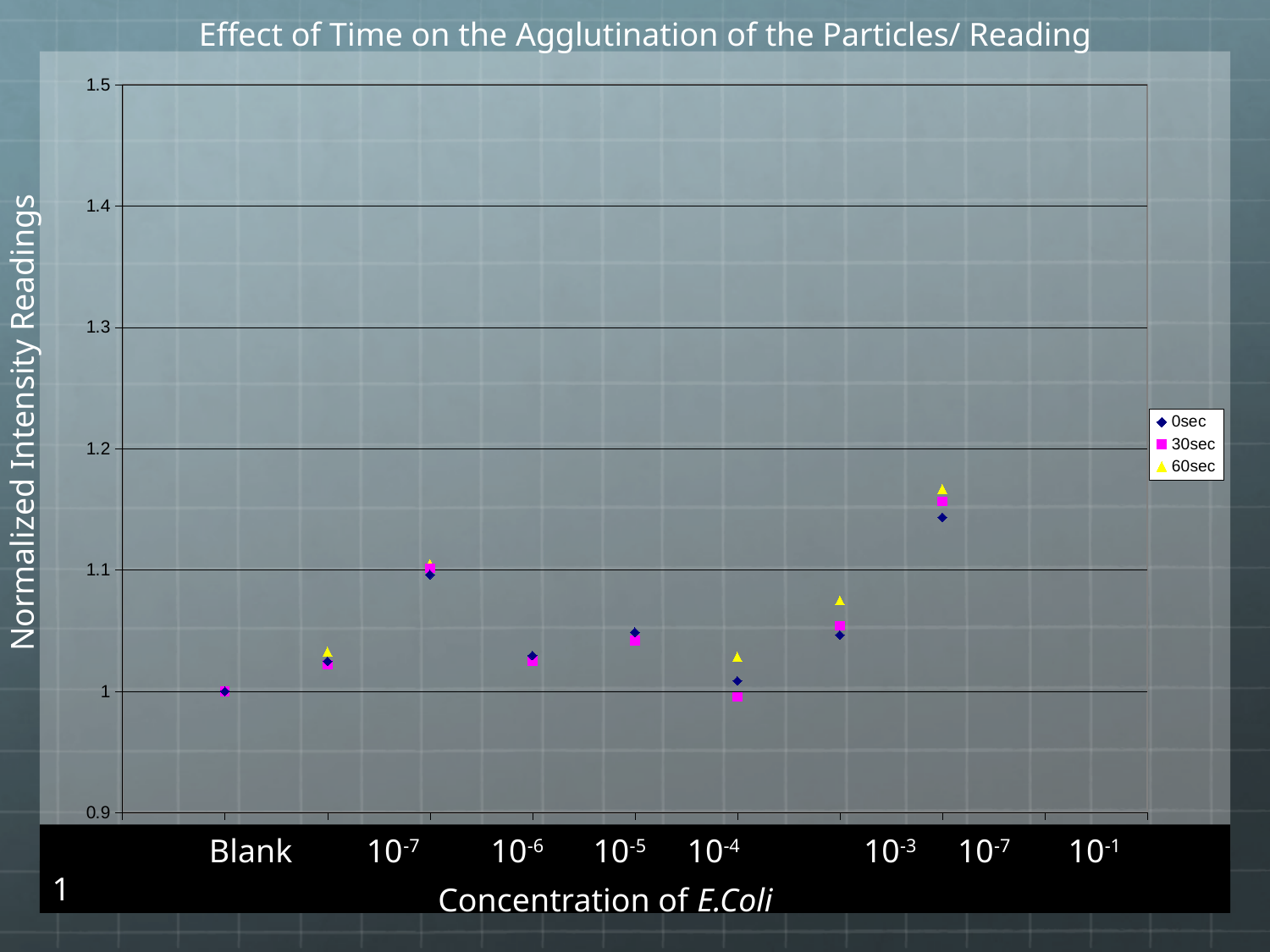
Is the 60sec reading at the rightmost plotted point greater or less than the 0sec reading at that point? greater How many data points are plotted for each series? 8 At the rightmost group of plotted points, which series has the lowest reading? 0sec What are the three series named in the legend? 0sec, 30sec, 60sec What is the maximum value shown on the y axis? 1.5 Is the highest plotted value on the chart greater or less than 1.2? less At the rightmost group of plotted points, which series has the highest reading? 60sec Is the highest plotted value on the chart greater or less than 1.1? greater What kind of chart is shown on the slide? scatter chart What is the normalized intensity reading for the Blank sample? 1 How many series does the legend list? 3 What is the title of the chart? Effect of Time on the Agglutination of the Particles/ Reading